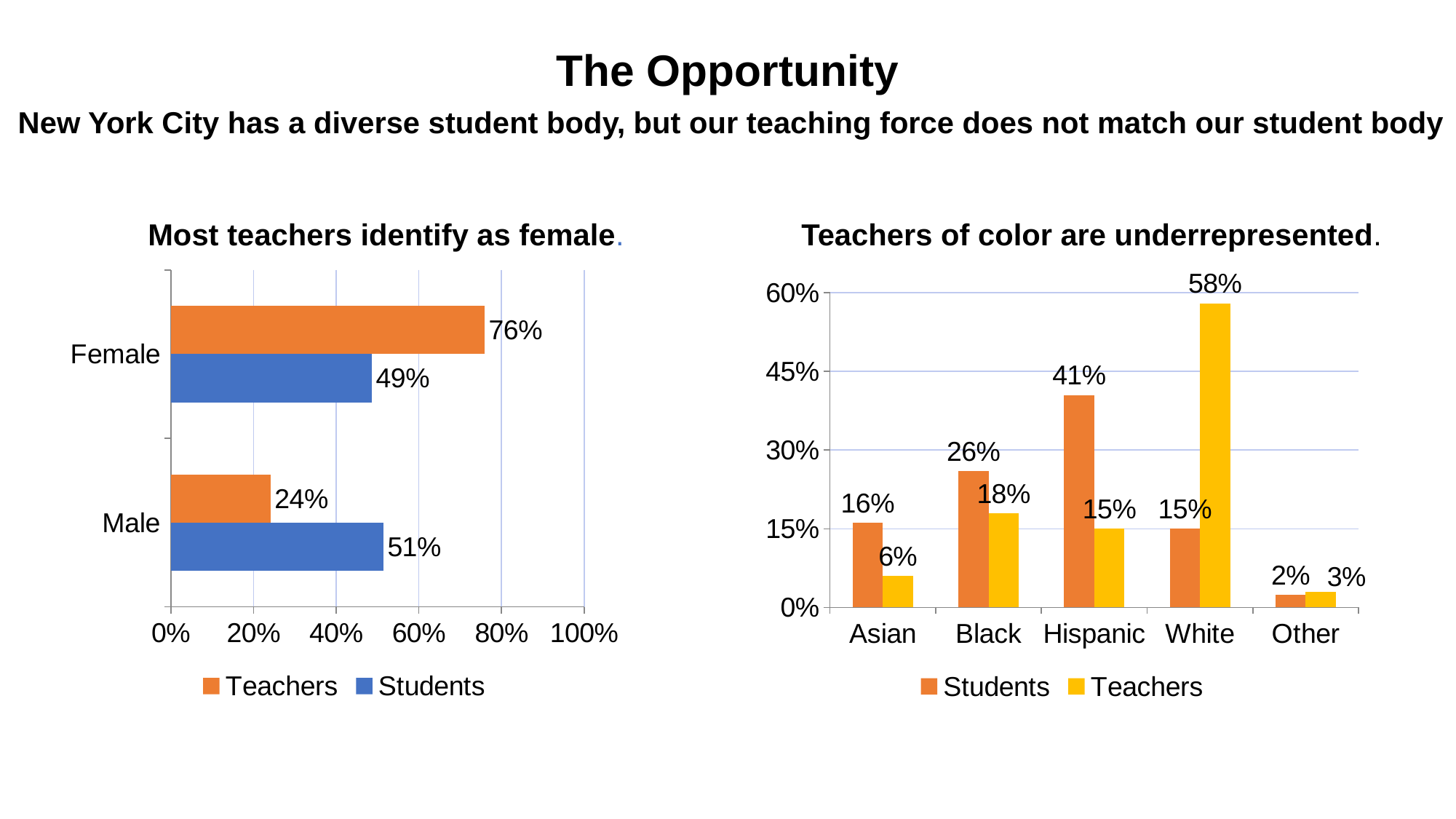
In the right chart (Teachers of color are underrepresented), how many categories are shown on the x axis? 5 In the right chart (Teachers of color are underrepresented), which category has the highest Students value? Hispanic In the left chart (Most teachers identify as female), what percentage of teachers are female? 76% In the right chart (Teachers of color are underrepresented), what percentage of students are Hispanic? 41% In the right chart (Teachers of color are underrepresented), what percentage of teachers are White? 58% What kind of chart is the left chart (Most teachers identify as female)? Bar chart In the left chart (Most teachers identify as female), what percentage of students are male? 51% In the left chart (Most teachers identify as female), how many series does the legend list? 2 In the right chart (Teachers of color are underrepresented), what is the difference between the Students and Teachers values for Hispanic? 26% In the left chart (Most teachers identify as female), what is the difference between the Teachers and Students values for Female? 27% In the left chart (Most teachers identify as female), which is larger for Male: Teachers or Students? Students In the right chart (Teachers of color are underrepresented), which category has the lowest Teachers value? Other